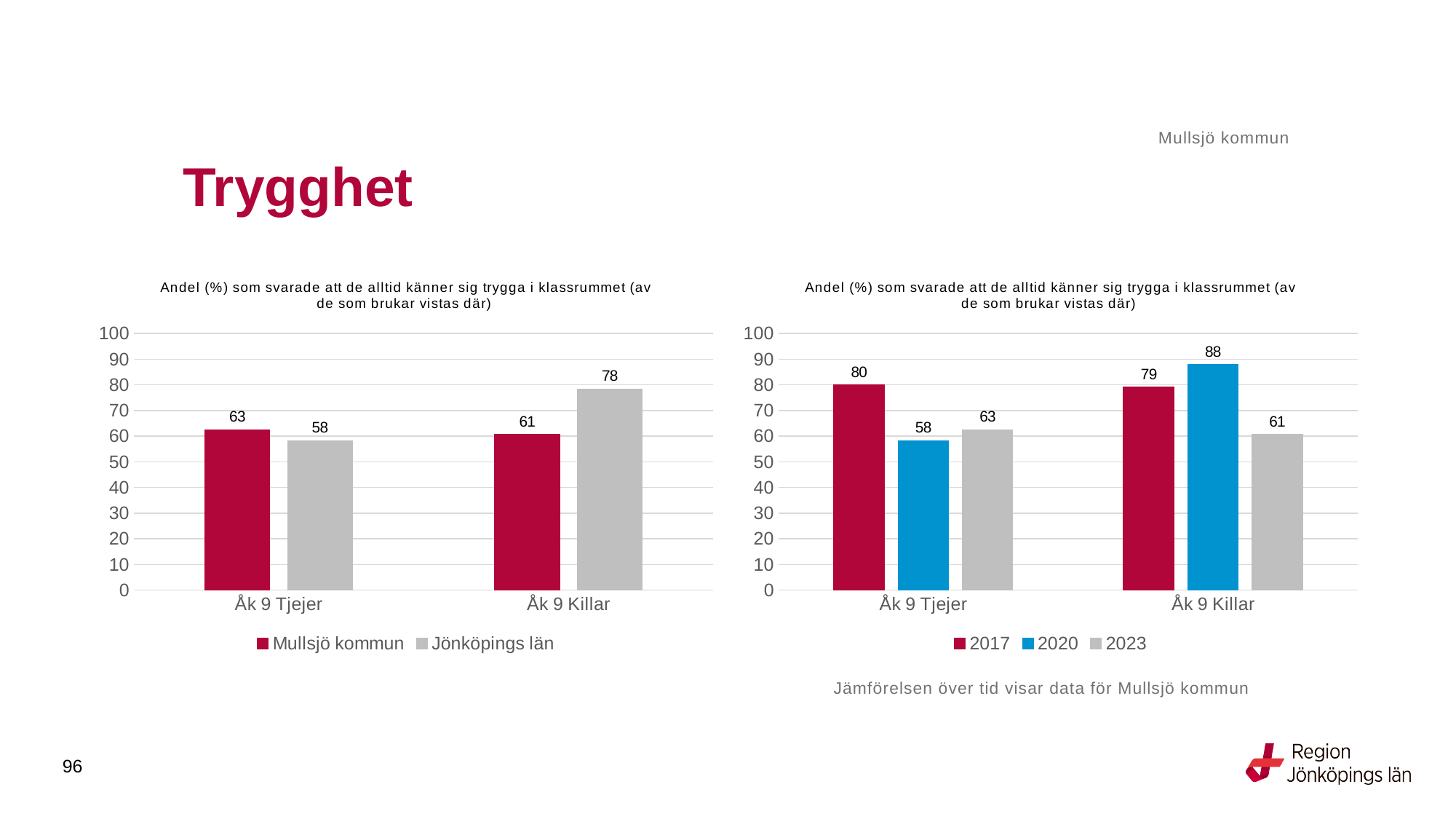
In the right chart, what is the difference between the 2020 and 2023 values for Åk 9 Killar? 27 In the left chart, which is larger for Åk 9 Tjejer: Mullsjö kommun or Jönköpings län? Mullsjö kommun In the right chart, which year has the lowest value for Åk 9 Tjejer? 2020 In the right chart, how many series does the legend list? 3 In the right chart, which year has the highest value for Åk 9 Killar? 2020 In the left chart, what is the value for Jönköpings län for Åk 9 Killar? 78 In the left chart, what is the difference between Jönköpings län and Mullsjö kommun for Åk 9 Killar? 17 In the left chart, what is the value for Mullsjö kommun for Åk 9 Tjejer? 63 In the right chart, what is the value for 2017 for Åk 9 Tjejer? 80 What kind of chart is the right chart? Bar chart In the right chart, what is the value for 2020 for Åk 9 Killar? 88 In the left chart, how many series does the legend list? 2